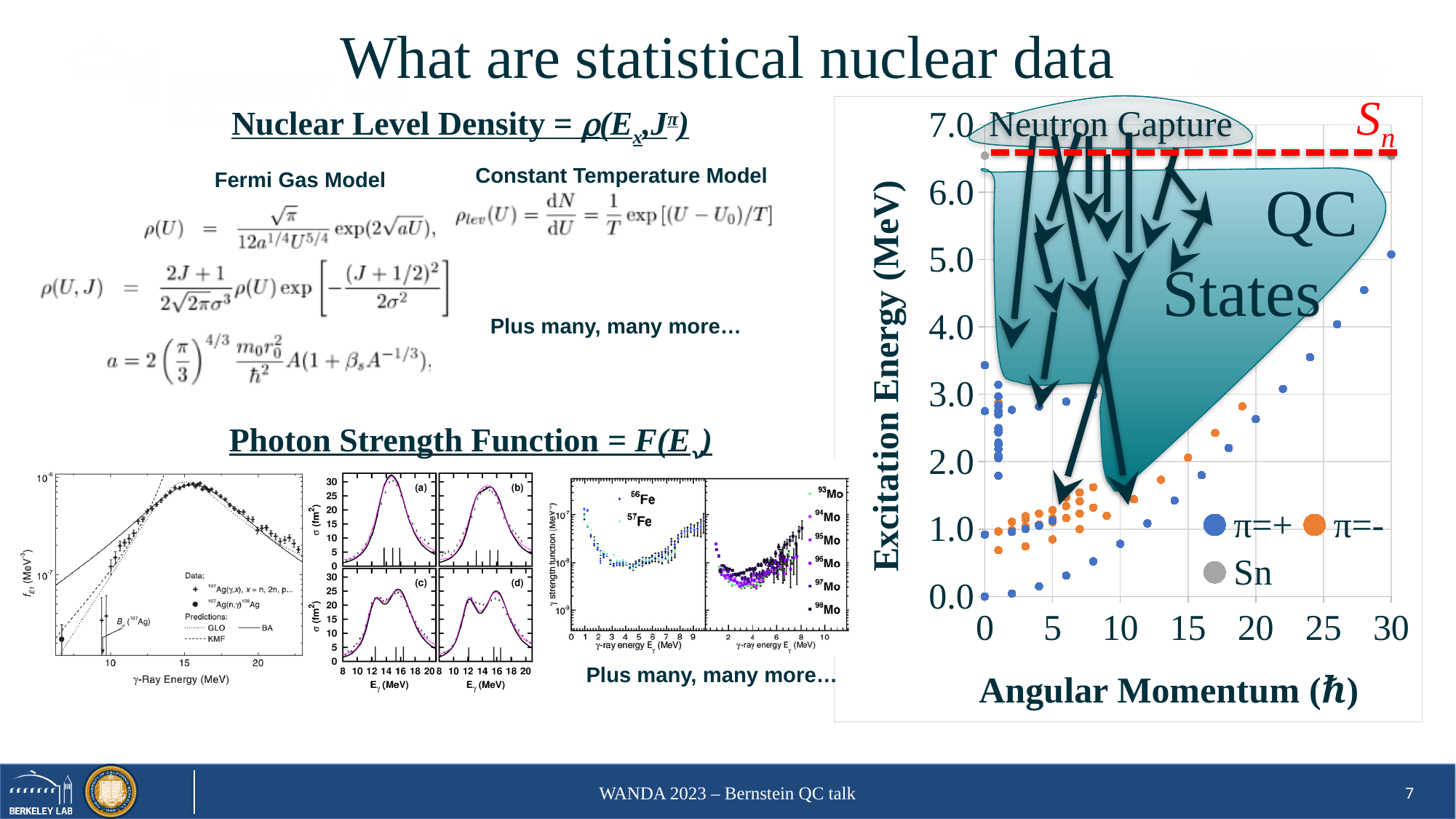
What kind of chart is the large chart on the right of the slide (Excitation Energy vs Angular Momentum)? scatter chart In the photon strength function plot showing Mo isotopes (bottom middle of the slide), how many Mo isotopes does the legend list? 6 How many series does the legend of the Excitation Energy vs Angular Momentum chart list? 3 On the Excitation Energy vs Angular Momentum chart, is the excitation energy of the blue point at angular momentum 30 greater or less than 4.0 MeV? greater On the Excitation Energy vs Angular Momentum chart, is the red dashed S_n line greater or less than 7.0 MeV? less What is the highest tick value shown on the y axis of the Excitation Energy vs Angular Momentum chart? 7.0 What is the x-axis label of the Excitation Energy chart on the right? Angular Momentum (ħ) On the Excitation Energy vs Angular Momentum chart, does the lowest excitation energy of the plotted states rise or fall as angular momentum increases from 0 to 30? rises On the Excitation Energy vs Angular Momentum chart, is the red dashed S_n line greater or less than 6.0 MeV? greater In the photon strength function plot showing Fe isotopes (bottom middle of the slide), how many series does the legend list? 2 On the Excitation Energy vs Angular Momentum chart, what colour are the π=+ points? blue